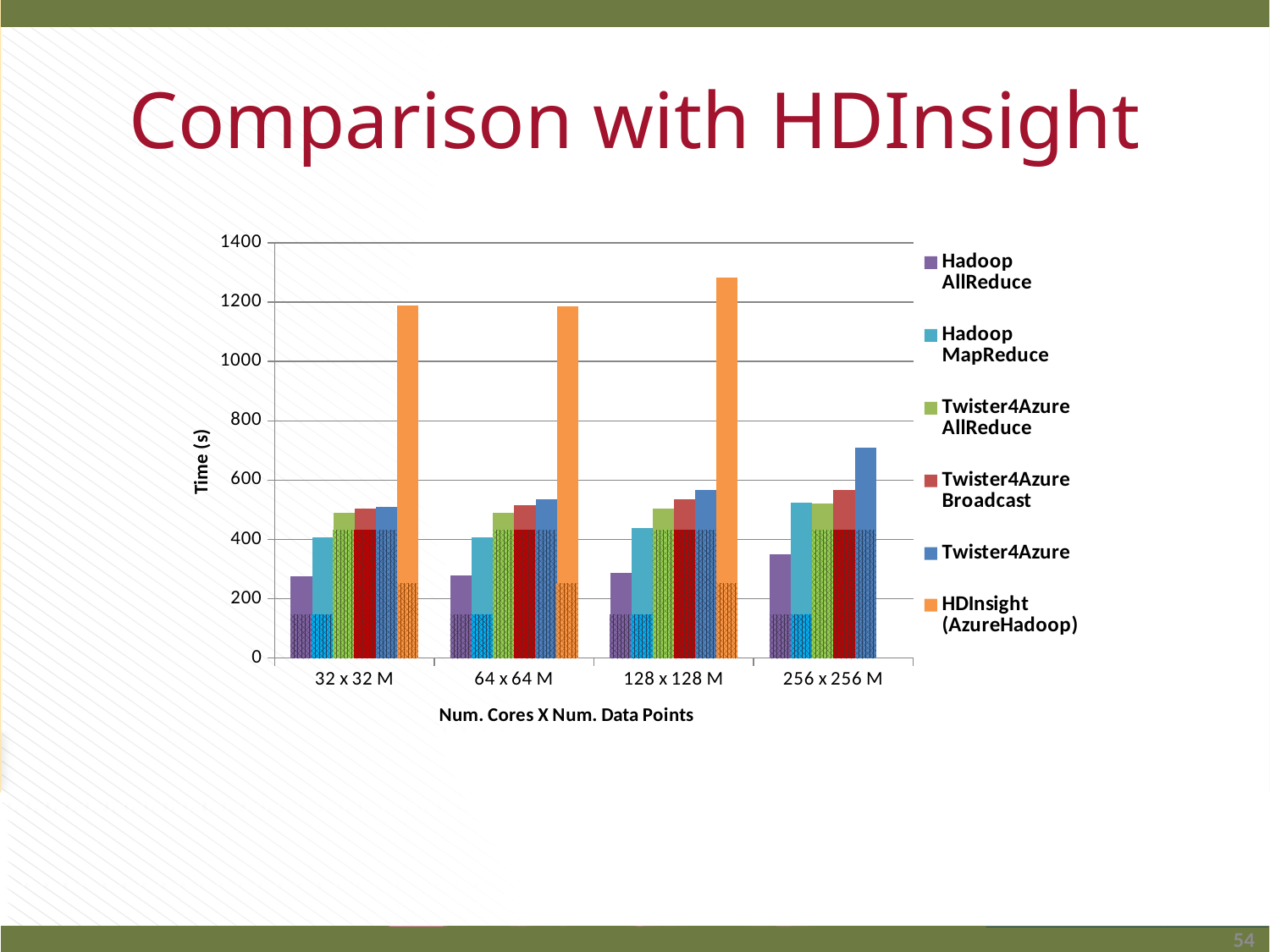
What kind of chart is shown on the slide? bar chart Is the value for HDInsight (AzureHadoop) at 32 x 32 M greater or less than 1000? greater Which series has the highest bar in the 256 x 256 M category? Twister4Azure How many series does the chart's legend list? 6 Which series has the tallest bar anywhere in the chart? HDInsight (AzureHadoop) Do the Twister4Azure values rise or fall from 32 x 32 M to 256 x 256 M? rise Is the value for Hadoop AllReduce at 32 x 32 M greater or less than 400? less Which is larger: the HDInsight (AzureHadoop) value at 128 x 128 M or at 32 x 32 M? 128 x 128 M What is the title of the x axis of the chart? Num. Cores X Num. Data Points Is the value for Twister4Azure at 256 x 256 M greater or less than 600? greater How many categories are shown on the x axis of the chart? 4 Which series has the lowest bar in the 32 x 32 M category? Hadoop AllReduce